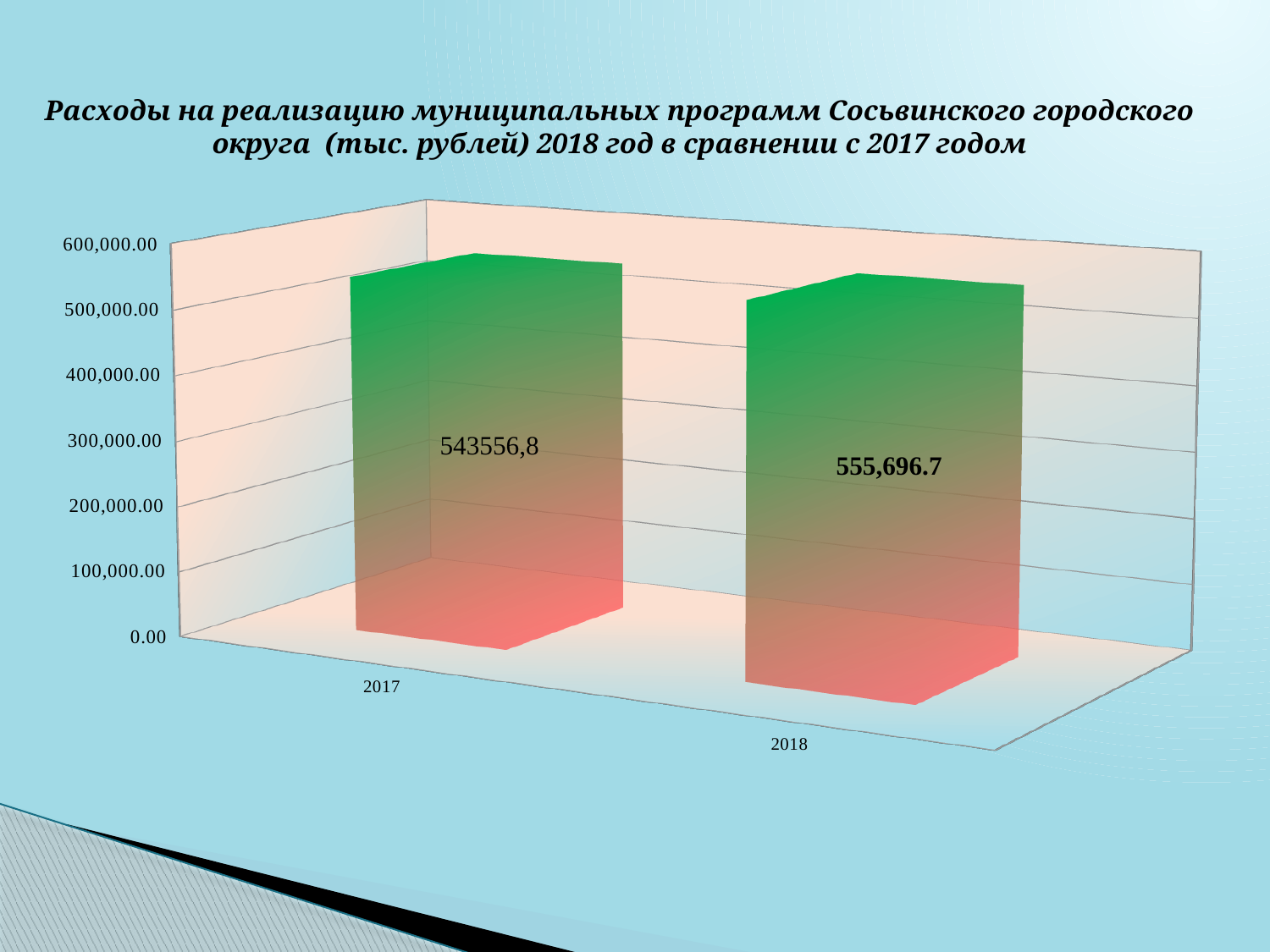
What is the value shown for 2018? 555,696.7 What is the value shown for 2017? 543556,8 Do the values rise or fall from 2017 to 2018? rise By how much does the 2018 value exceed the 2017 value? 12,139.9 Is the value for 2017 greater or less than 500,000.00? greater Is the value for 2018 greater or less than 600,000.00? less In what units are the expenses expressed according to the slide title? тыс. рублей How many years (categories) are plotted on the chart? 2 Which year has the higher value according to the data labels? 2018 What kind of chart is shown on the slide? bar chart Which year has the lower value according to the data labels? 2017 Is the value for 2018 larger or smaller than the value for 2017? larger